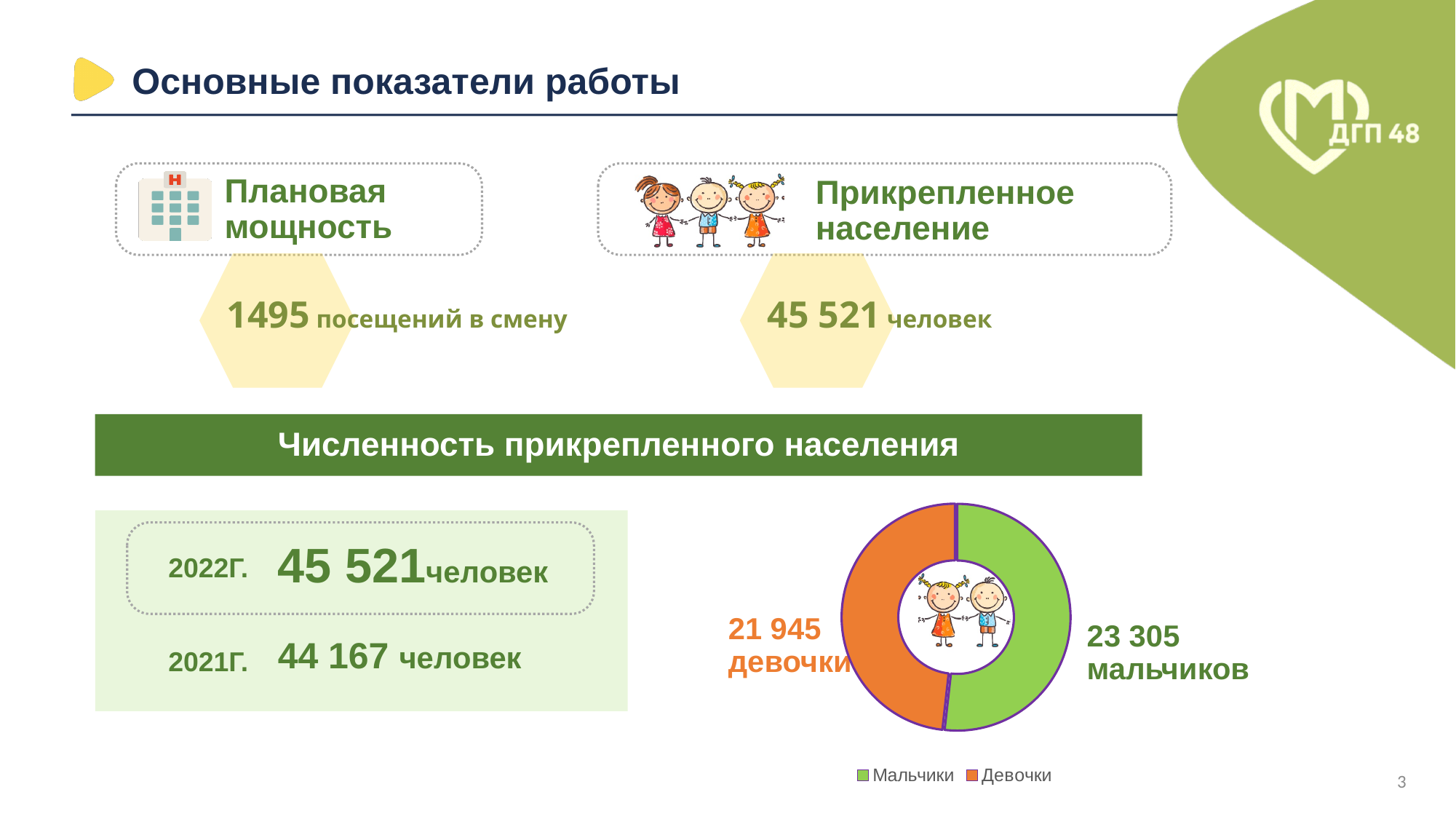
What value is shown for Девочки (girls) in the doughnut chart? 21 945 What type of chart is shown on the slide? doughnut chart What is the difference between the number of boys (Мальчики) and girls (Девочки) in the doughnut chart? 1 360 How many series does the legend of the doughnut chart list? 2 How many slices does the doughnut chart have? 2 Which category has the largest slice in the doughnut chart? Мальчики What are the two entries in the legend of the doughnut chart? Мальчики, Девочки What value is shown for Мальчики (boys) in the doughnut chart? 23 305 Which category has the larger slice in the doughnut chart, Мальчики or Девочки? Мальчики Which category has the smallest slice in the doughnut chart? Девочки What is the total of the two slices in the doughnut chart? 45 250 Which colour represents Девочки in the doughnut chart? orange